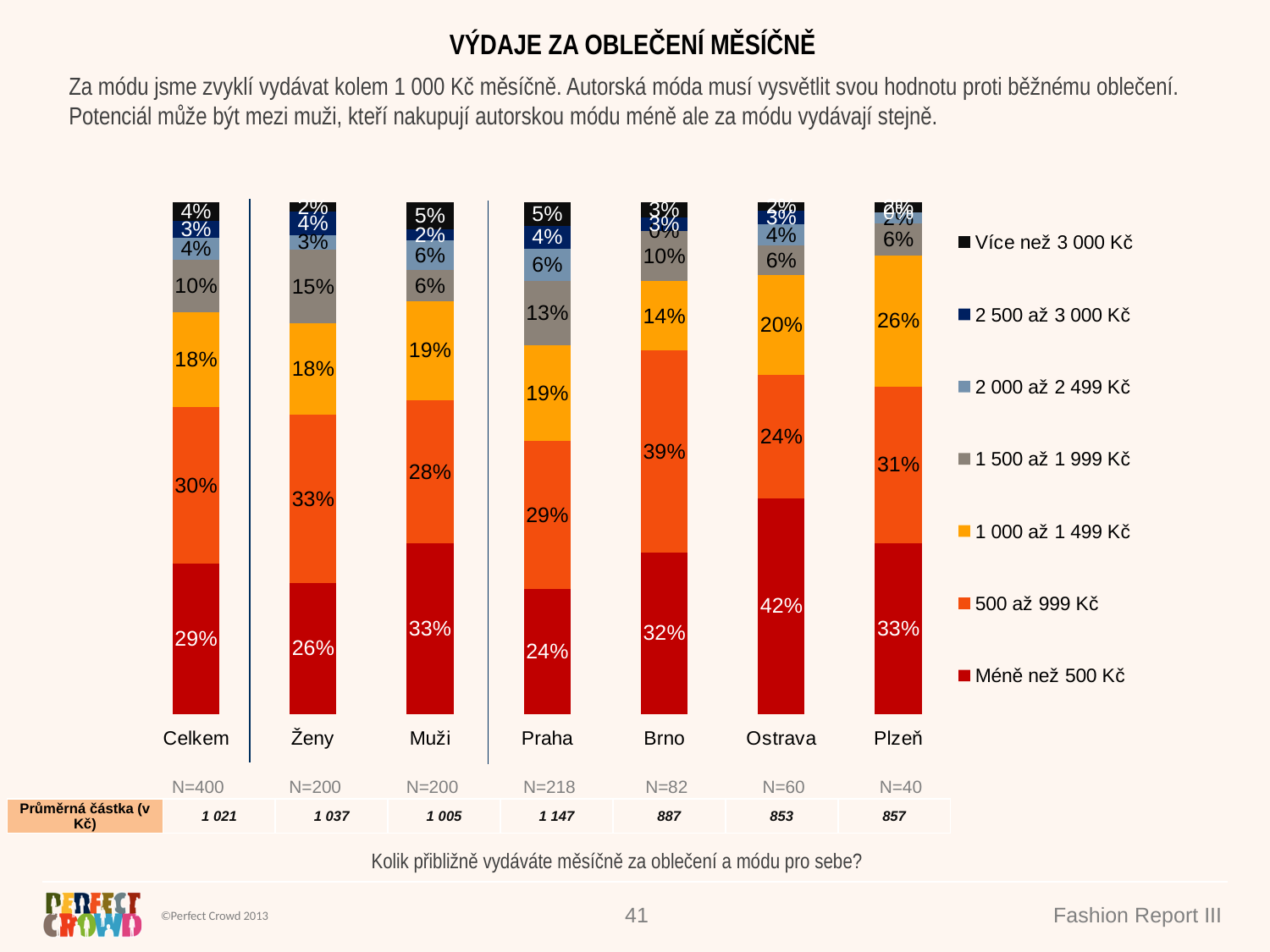
Which is larger: the '1 500 až 1 999 Kč' value for Praha or for Celkem? Praha Which category has the highest value for the 'Méně než 500 Kč' segment? Ostrava What is the value of the '500 až 999 Kč' segment for Brno? 39% How many categories (bars) are shown on the x axis? 7 How many series does the legend list? 7 What kind of chart is shown on the slide? stacked bar chart What is the value of the '1 500 až 1 999 Kč' segment for Ženy? 15% What is the difference between the '500 až 999 Kč' values for Ženy and Muži? 5% What is the value of the '1 000 až 1 499 Kč' segment for Plzeň? 26% Which category has the lowest value for the 'Méně než 500 Kč' segment? Praha What is the value of the 'Méně než 500 Kč' segment for Ostrava? 42% What is the average amount (Průměrná částka v Kč) shown for Praha? 1 147